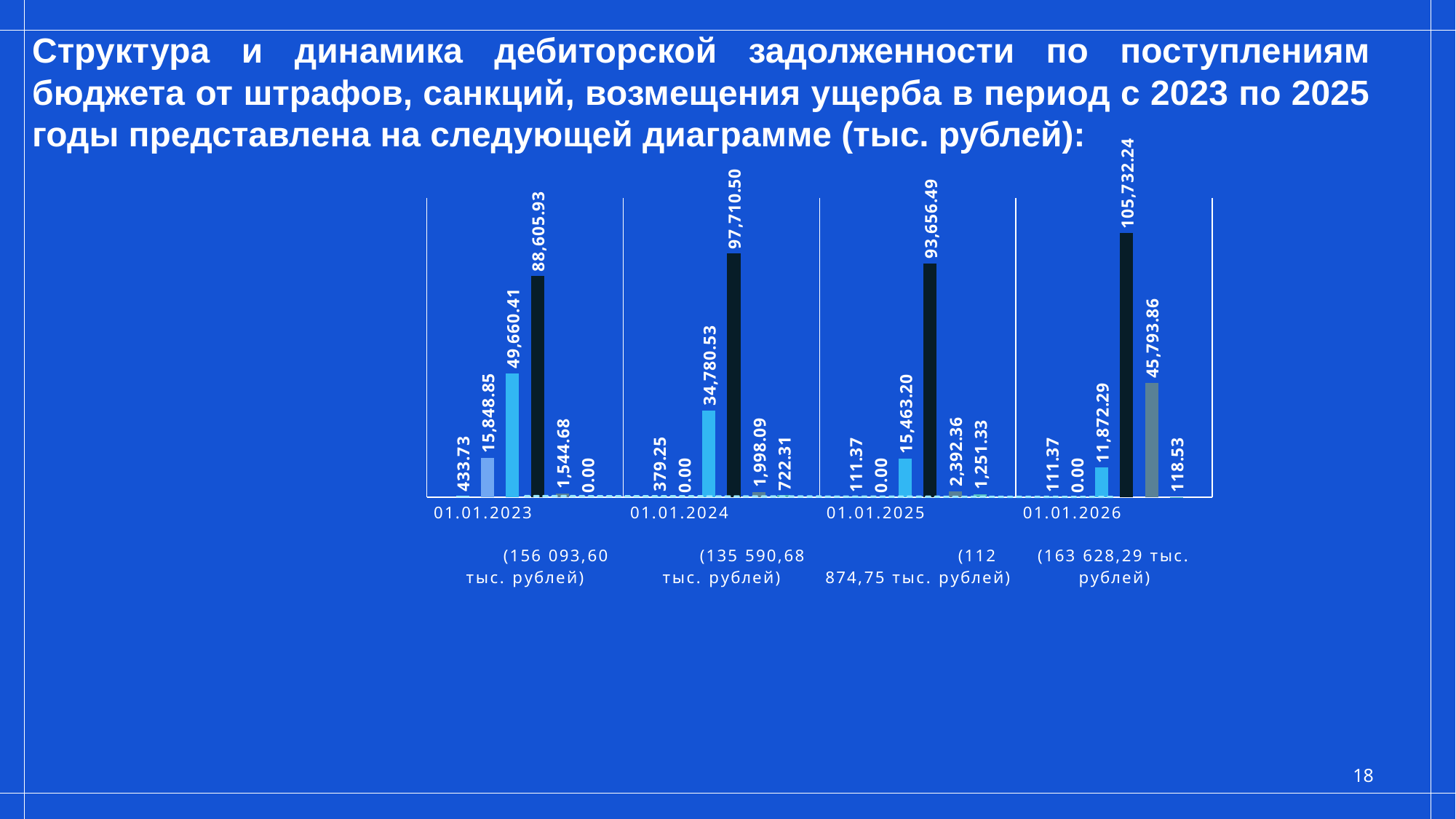
What is the value of the grey bar for 01.01.2026? 45,793.86 How many bars are plotted in each date group? 6 For which date is the tallest (black) bar the highest? 01.01.2026 What is the difference between the black bar values for 01.01.2026 (105,732.24) and 01.01.2023 (88,605.93)? 17,126.31 What is the value of the light blue (cyan) bar for 01.01.2023? 49,660.41 How do the light blue (cyan) bar values change from 01.01.2023 to 01.01.2026? they fall How many date categories are shown on the x axis of the chart? 4 What type of chart is shown on the slide? bar chart For which date is the tallest (black) bar the lowest? 01.01.2023 What is the value of the tallest (black) bar for 01.01.2024? 97,710.50 What total (in parentheses) is printed under the 01.01.2025 category? 112 874,75 тыс. рублей Which is larger: the light blue bar for 01.01.2024 or the light blue bar for 01.01.2025? 01.01.2024